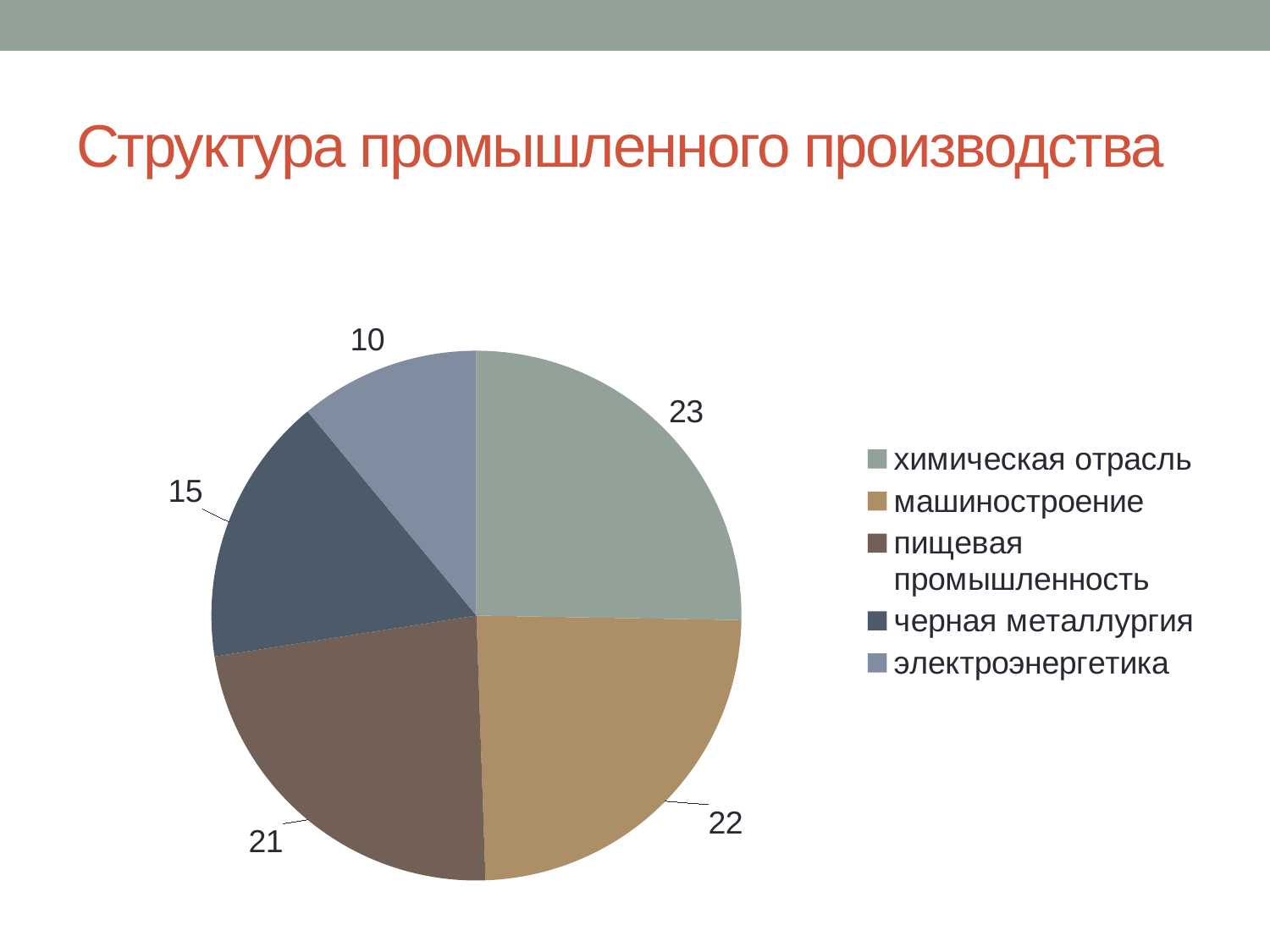
How many categories does the legend list? 5 Which is larger, the value for черная металлургия or the value for пищевая промышленность? пищевая промышленность What type of chart is shown on the slide? pie chart What is the value for электроэнергетика? 10 Which category has the smallest slice of the pie? электроэнергетика What is the value for машиностроение? 22 What is the difference between the values for химическая отрасль and электроэнергетика? 13 What is the value for черная металлургия? 15 Which category has the largest slice of the pie? химическая отрасль What is the title of the chart on the slide? Структура промышленного производства What is the value for пищевая промышленность? 21 What is the value for химическая отрасль? 23